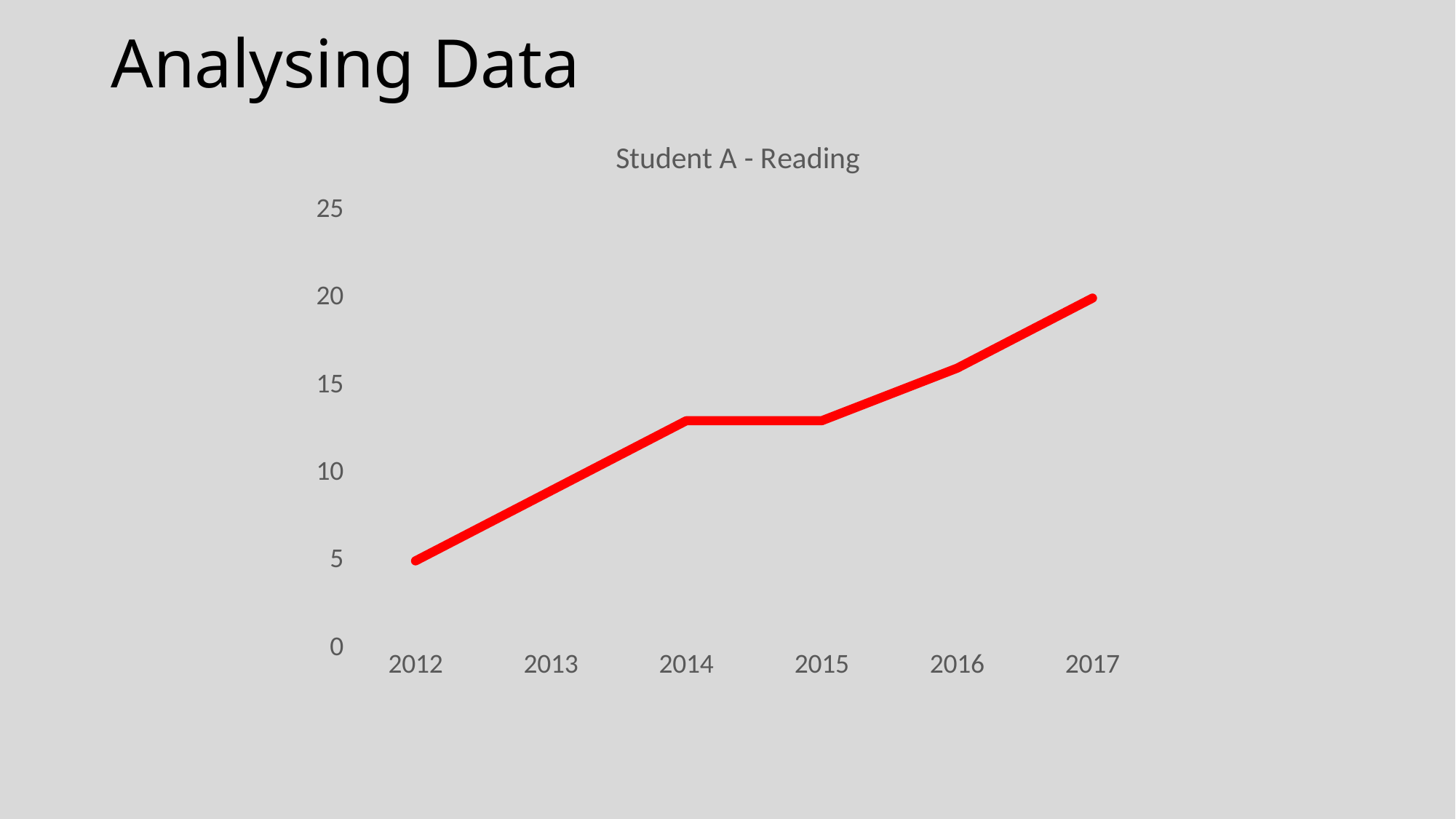
Is the value for 2013 greater or less than 10? less Do the values generally rise or fall from 2012 to 2017? rise How many years are plotted on the x axis? 6 Which year has the highest value? 2017 Which year has the lowest value? 2012 What kind of chart is shown on the slide? line chart What is the value for 2017? 20 Is the value for 2014 greater or less than 10? greater What is the difference between the values for 2017 and 2012? 15 What is the value for 2012? 5 Which is larger, the value for 2016 or the value for 2014? 2016 What is the title of the chart? Student A - Reading